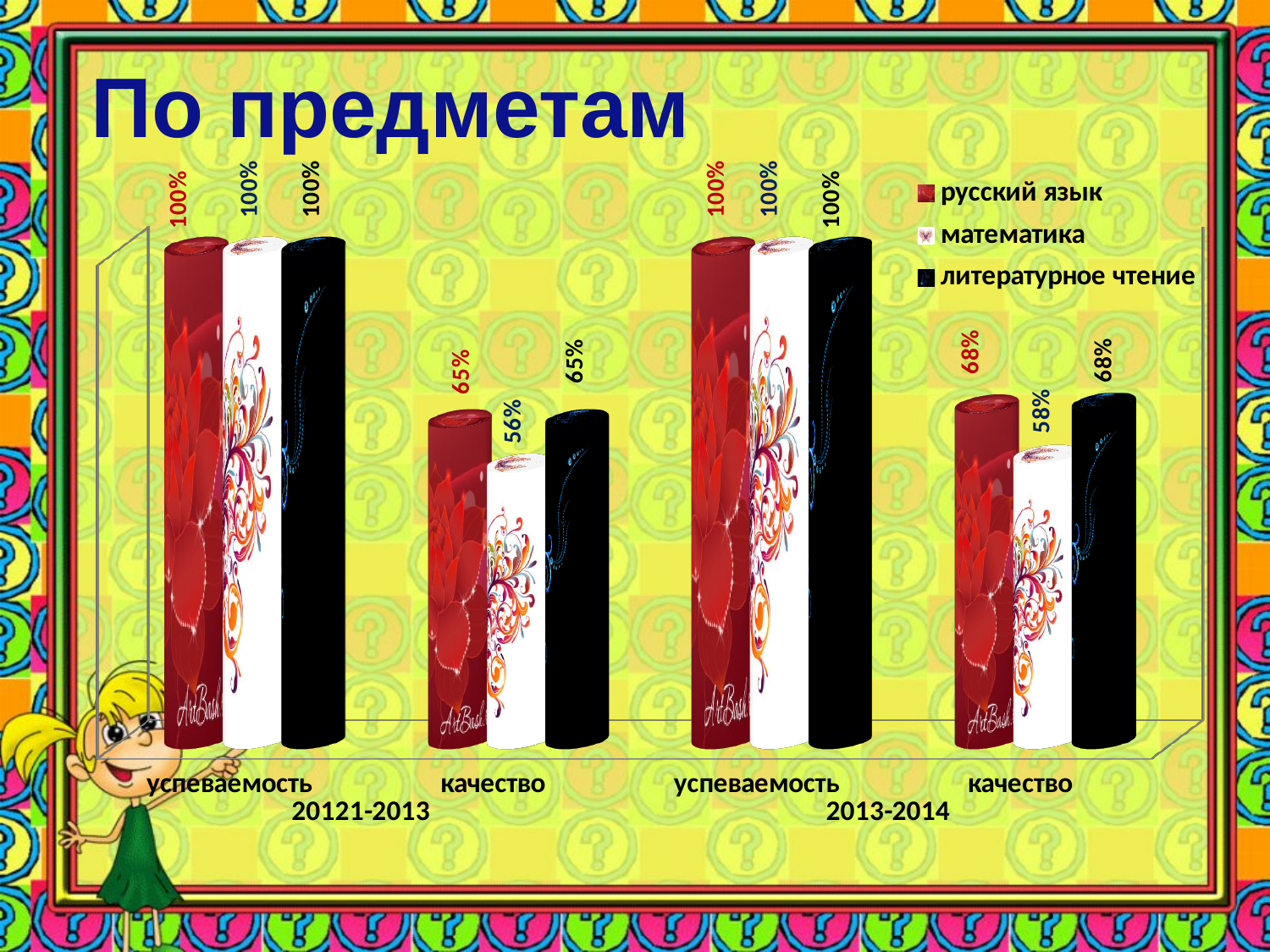
What is the difference between русский язык and математика in the качество group for 2013-2014? 10% Which is larger: математика in качество for 20121-2013 or математика in качество for 2013-2014? математика in качество for 2013-2014 Which series has the lowest value in the качество group for 20121-2013? математика What is the value for литературное чтение in the успеваемость group for 2013-2014? 100% What is the title of the chart? По предметам What is the difference between литературное чтение and математика in the качество group for 20121-2013? 9% What is the value for математика in the качество group for 20121-2013? 56% What is the value for математика in the качество group for 2013-2014? 58% How many series does the legend list? 3 How many category groups are shown along the x axis? 4 What is the value for русский язык in the качество group for 2013-2014? 68% What kind of chart is shown on the slide? bar chart